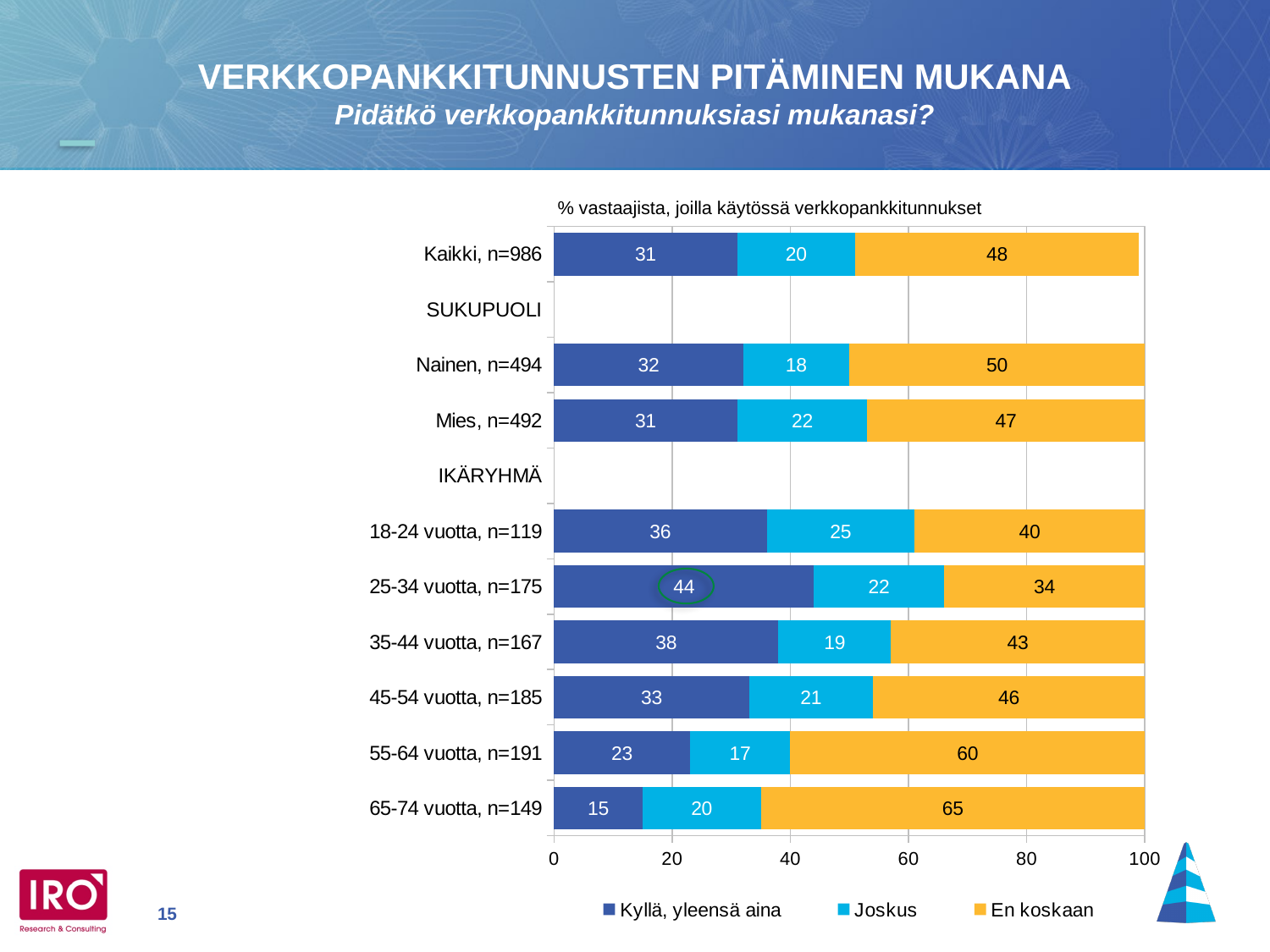
What is the difference between the "En koskaan" values for "55-64 vuotta, n=191" and "25-34 vuotta, n=175"? 26 What kind of chart is shown on the slide? Stacked bar chart How many age groups are shown in the chart? 6 Which series is shown in yellow/orange in the chart? En koskaan What is the total of the stacked bar for "35-44 vuotta, n=167"? 100 What is the value of "Joskus" for "18-24 vuotta, n=119"? 25 How many series does the legend list? 3 Which category has the lowest value for "Kyllä, yleensä aina"? 65-74 vuotta, n=149 What is the value of "En koskaan" for "65-74 vuotta, n=149"? 65 Which is larger: the "Joskus" value for "Nainen, n=494" or for "Mies, n=492"? Mies, n=492 What is the value of "Kyllä, yleensä aina" for "Kaikki, n=986"? 31 Which age group has the highest value for "Kyllä, yleensä aina"? 25-34 vuotta, n=175